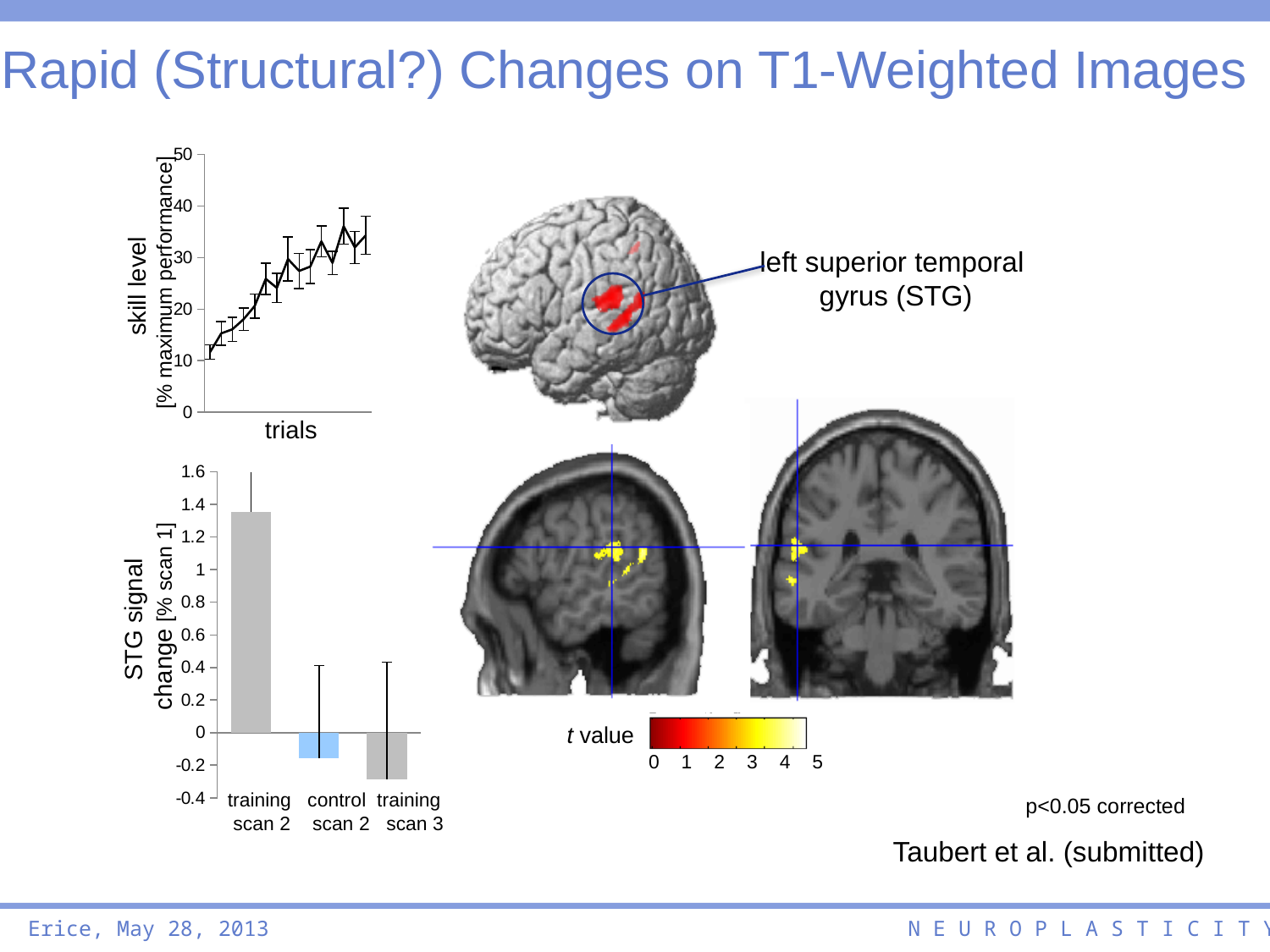
What kind of chart is the skill level chart at the top left of the slide? line chart In the skill level chart, does skill level rise or fall across trials? rise In the STG signal change bar chart, which category has the highest value? training scan 2 In the skill level chart, is the value at the first trial greater or less than 20? less In the STG signal change bar chart, is the value for training scan 2 greater or less than 1? greater In the STG signal change bar chart, which is larger: training scan 2 or training scan 3? training scan 2 How many categories are shown in the STG signal change bar chart? 3 What is the x-axis label of the skill level chart? trials In the STG signal change bar chart, is the value for control scan 2 greater or less than 0? less In the STG signal change bar chart, which category has the lowest value? training scan 3 In the STG signal change bar chart, which category's bar is coloured light blue? control scan 2 What kind of chart is the STG signal change chart at the bottom left of the slide? bar chart